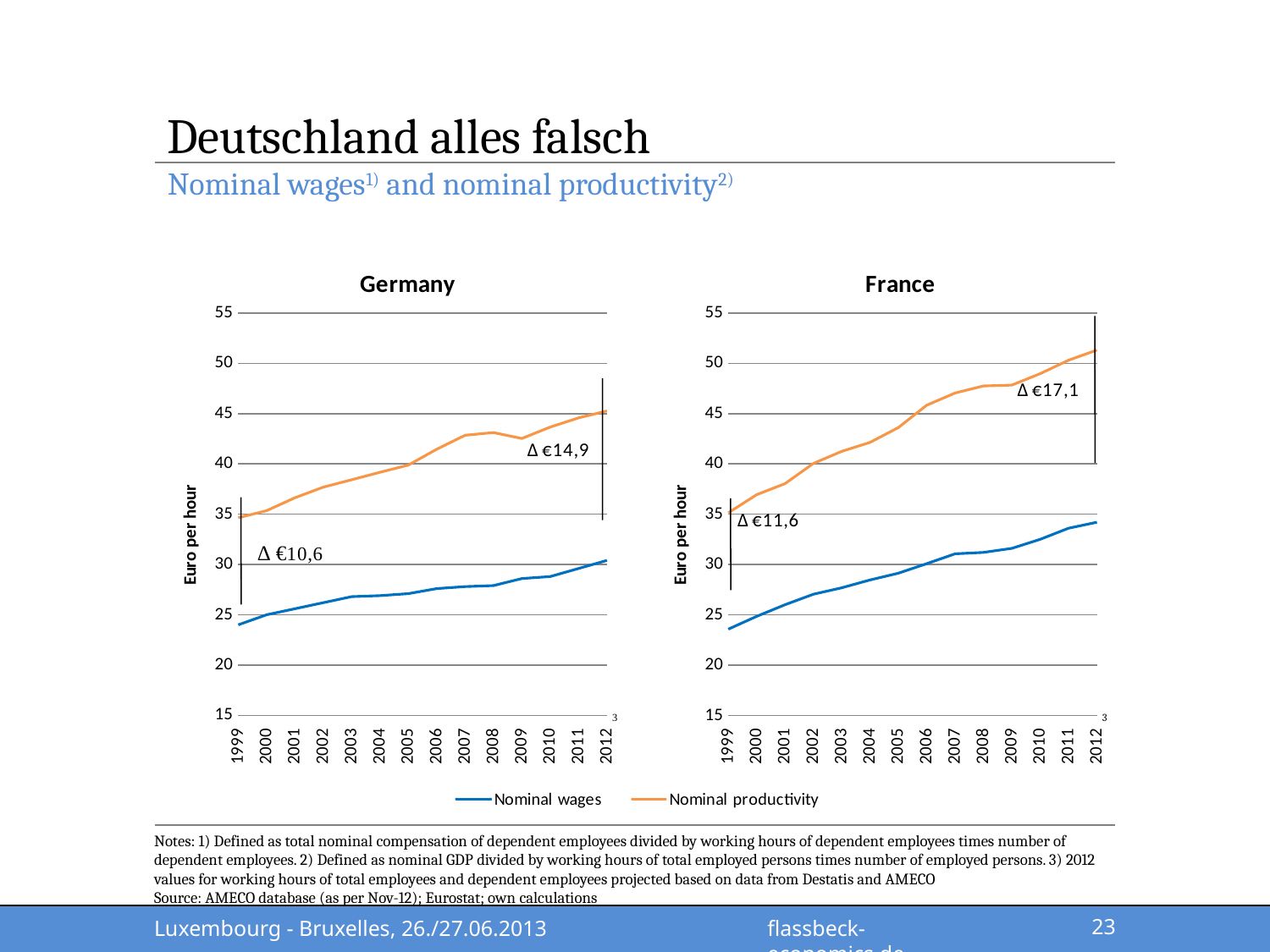
On the France chart, is the value for nominal productivity in 2012 greater or less than 45? greater On the France chart, by how much did the annotated gap grow between 1999 (Δ €11,6) and 2012 (Δ €17,1)? €5,5 On the Germany chart, what gap between nominal productivity and nominal wages is annotated for 2012? Δ €14,9 On the Germany chart, does nominal productivity rise or fall from 1999 to 2012? Rise Which chart shows the larger annotated 2012 gap between productivity and wages, Germany or France? France On the France chart, what gap between nominal productivity and nominal wages is annotated for 2012? Δ €17,1 How many series does the legend list? 2 On the Germany chart, what gap between nominal productivity and nominal wages is annotated for 1999? Δ €10,6 What kind of chart is the Germany chart? Line chart On the Germany chart, is the value for nominal wages in 2012 greater or less than 35? less How many years are shown on the x axis of the France chart? 14 On the France chart, what gap between nominal productivity and nominal wages is annotated for 1999? Δ €11,6